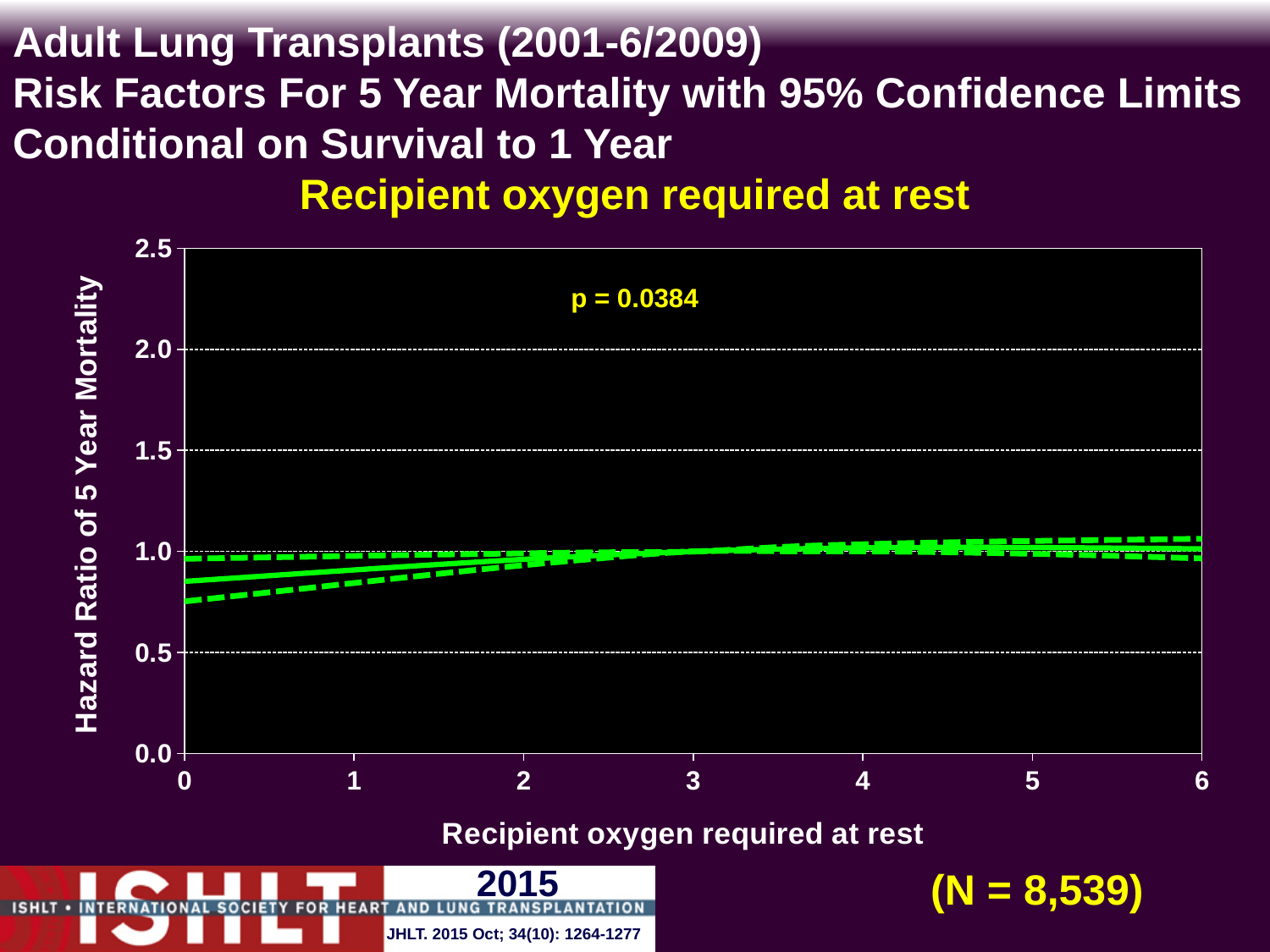
Is the lower 95% confidence limit at a recipient oxygen value of 0 greater or less than 1.0? less What p-value is printed on the chart? p = 0.0384 Does the hazard ratio curve rise or fall as recipient oxygen required at rest increases from 0 to 6? rise How many lines (the estimate plus its confidence limits) are plotted on the chart? 3 Is the hazard ratio of the solid line at a recipient oxygen value of 0 greater or less than 1.0? less What is the label of the x axis? Recipient oxygen required at rest What kind of chart is shown on the slide? line chart What sample size (N) is shown on the slide? N = 8,539 Is the upper 95% confidence limit at a recipient oxygen value of 6 greater or less than 1.5? less What is the highest value shown on the y axis? 2.5